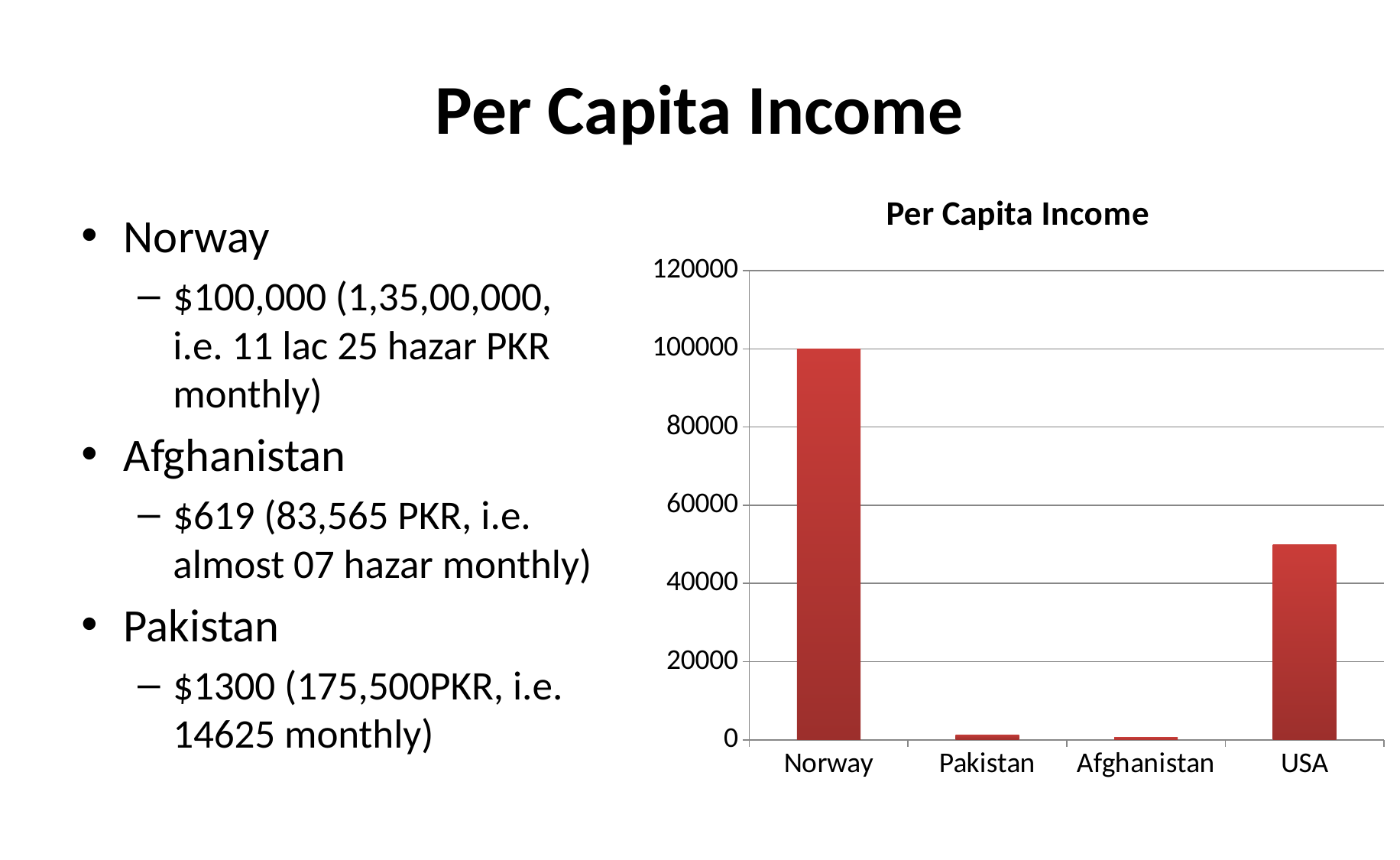
What kind of chart is shown on the slide? bar chart What is the title of the chart? Per Capita Income What is the per capita income value for Norway in the chart? 100000 What is the highest value shown on the y axis of the chart? 120000 Which country has the highest per capita income in the chart? Norway Which is larger, the value for Norway or the value for USA? Norway Is the value for USA greater or less than 60000? less Is the value for Afghanistan greater or less than 20000? less Is the value for Pakistan greater or less than 20000? less How many countries are shown on the x axis of the chart? 4 Which is larger, the value for USA or the value for Pakistan? USA